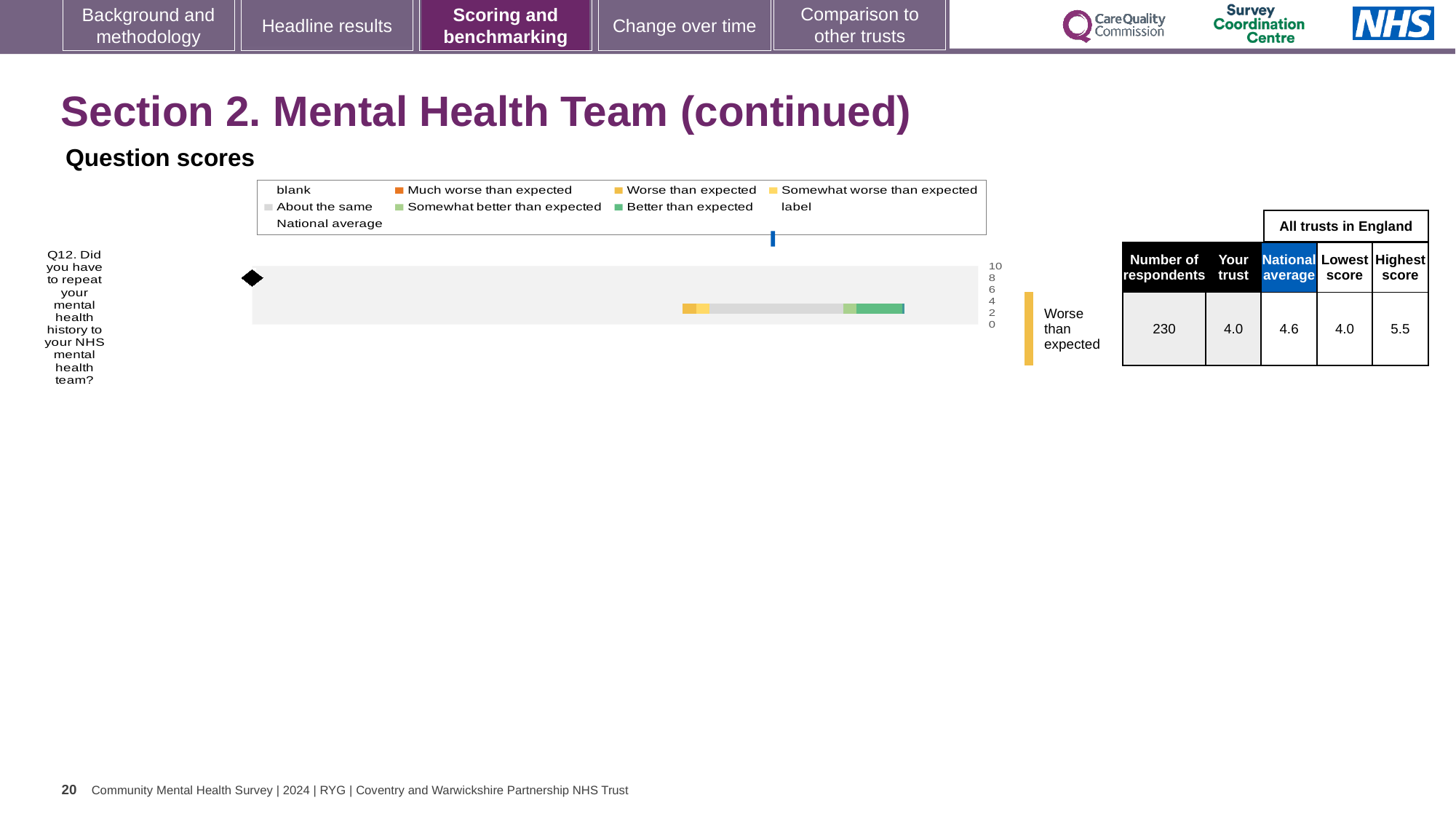
In the table beside the chart, what is the national average score for Q12? 4.6 What benchmark category label is shown to the right of the Q12 bar? Worse than expected In the table beside the chart, what is the highest score among all trusts in England for Q12? 5.5 In the table beside the chart, what is the lowest score among all trusts in England for Q12? 4.0 Which question is plotted in the Question scores chart? Q12. Did you have to repeat your mental health history to your NHS mental health team? For Q12, which is larger: the 'Your trust' score or the national average? National average In the table beside the chart, what is the number of respondents for Q12? 230 For Q12, how much higher is the national average than the 'Your trust' score? 0.6 In the table beside the chart, what is the 'Your trust' score for Q12? 4.0 How many survey questions are plotted in the Question scores chart? 1 For Q12, what is the difference between the highest score and the lowest score among all trusts in England? 1.5 What kind of chart is shown under 'Question scores'? bar chart